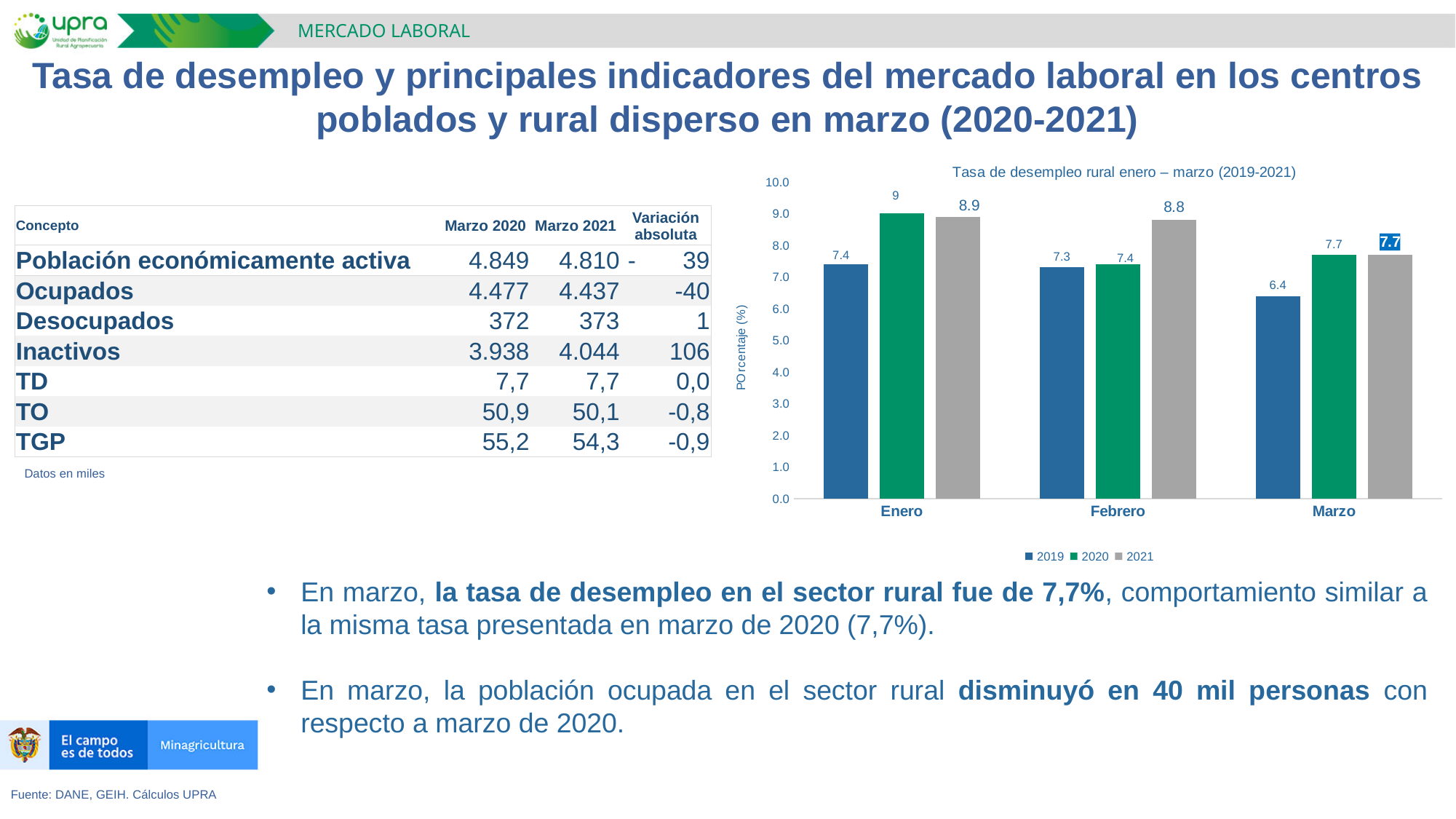
What is the difference between the 2021 and 2019 values in Enero? 1.5 How many month categories are shown on the x axis of the chart? 3 What type of chart is shown on the slide? bar chart What is the value for 2021 in Febrero? 8.8 Which month has the highest value for the 2020 series? Enero How many series does the chart legend list? 3 What is the value for 2020 in Enero? 9 Do the values for the 2019 series rise or fall from Enero to Marzo? fall Which is larger in Febrero, the 2020 value or the 2021 value? 2021 What is the title of the chart? Tasa de desempleo rural enero – marzo (2019-2021) Which month has the lowest value for the 2019 series? Marzo What is the value for 2019 in Marzo? 6.4